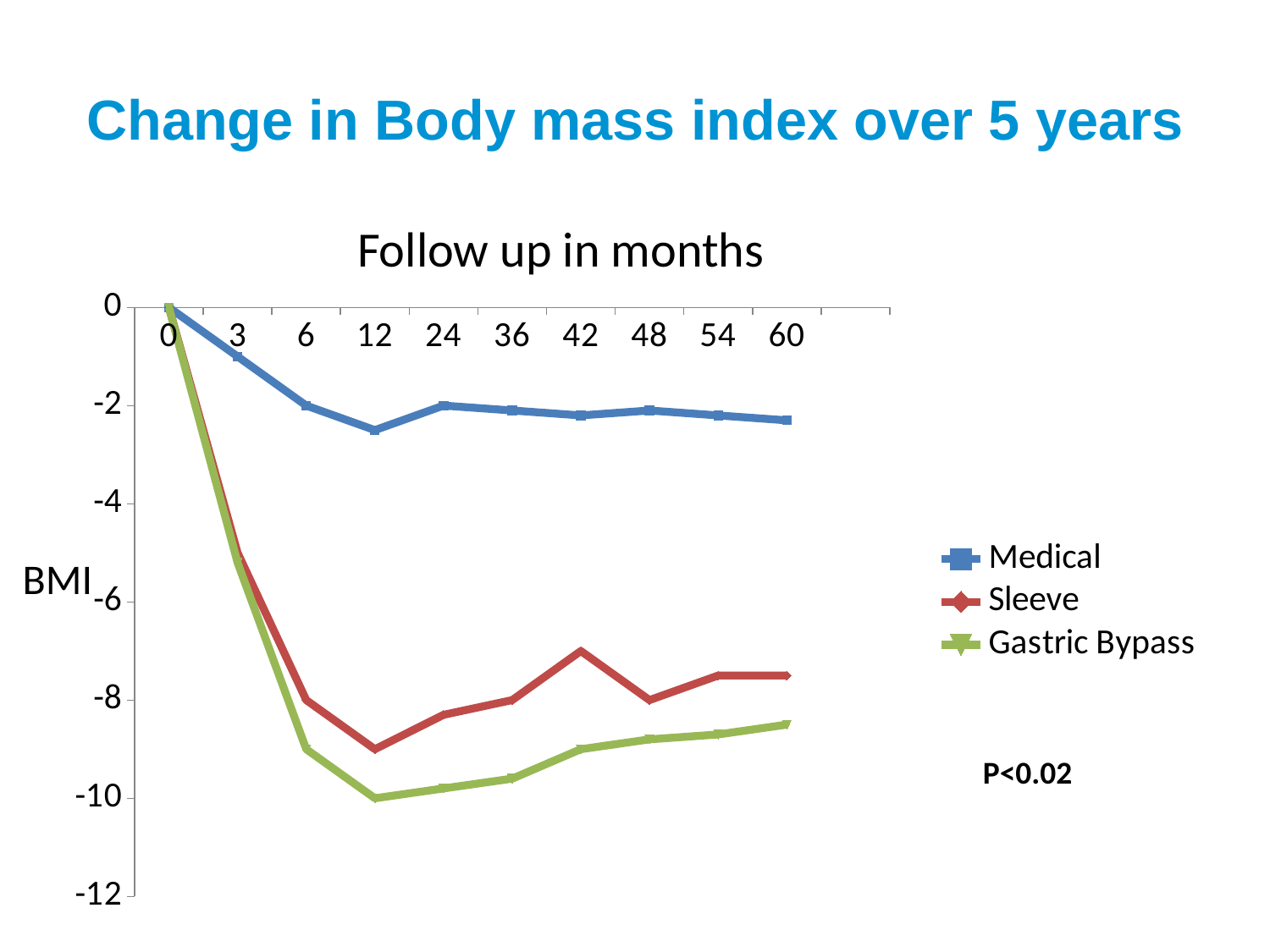
What is the BMI change for Gastric Bypass at 12 months? -10 Which series reaches the lowest BMI change on the chart? Gastric Bypass What kind of chart is shown on the slide? line chart Is the value for Gastric Bypass at 60 months greater or less than -8? less At 60 months, which series has the higher (less negative) BMI change, Sleeve or Gastric Bypass? Sleeve Which series shows the smallest change in BMI across the follow-up period? Medical What is the BMI change for Sleeve at 6 months? -8 Is the value for Medical at 60 months greater or less than -2? less How many follow-up time points are shown on the x axis? 10 How many series does the legend list? 3 What p-value is printed next to the chart? P<0.02 Does the Medical line rise or fall between 0 and 12 months? fall